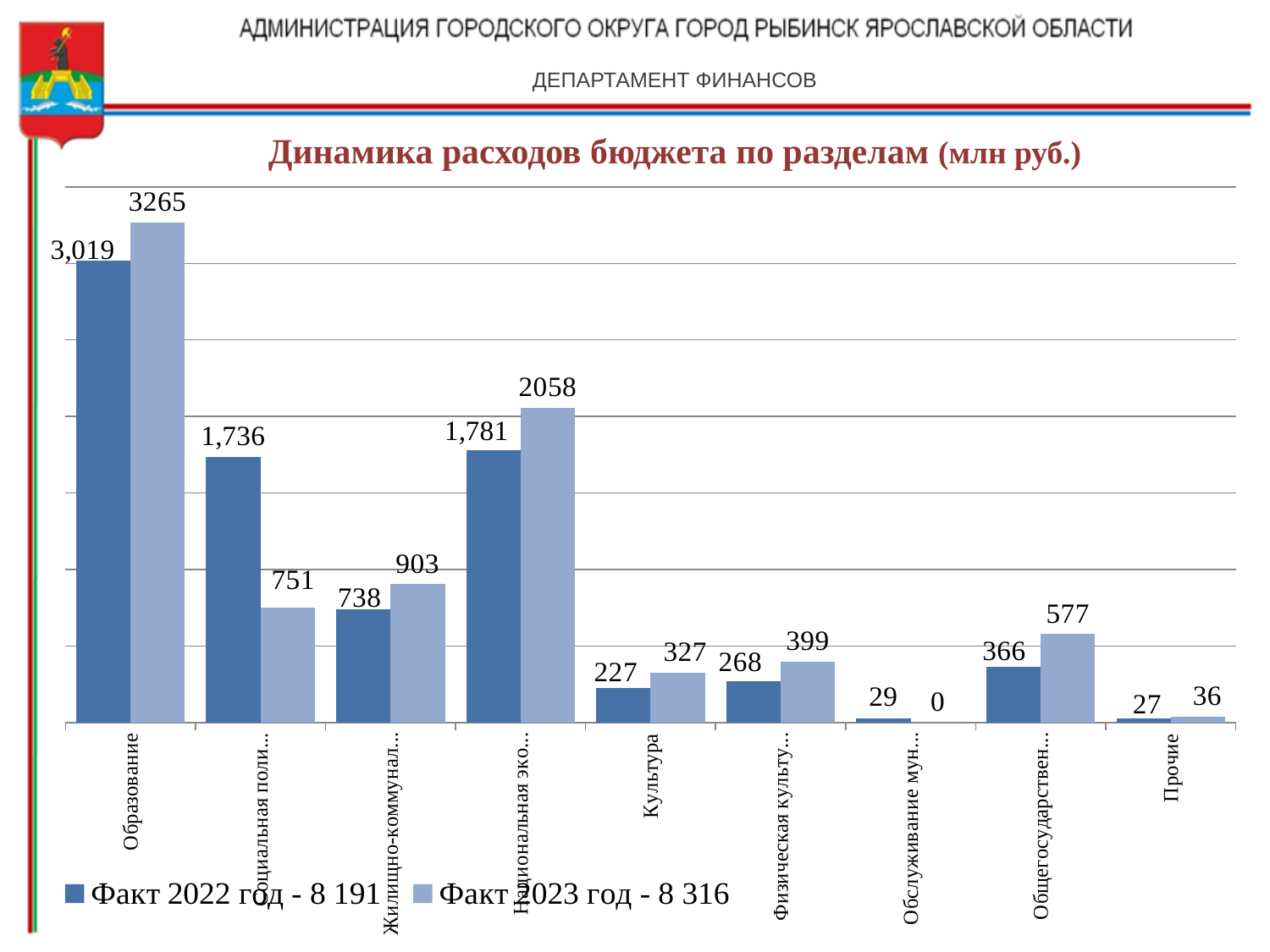
What is the value for Образование in the series Факт 2023 год? 3265 How many categories are shown on the x axis? 9 What is the difference between the Факт 2023 год and Факт 2022 год values for Образование? 246 Which category has the lowest value in the series Факт 2022 год? Прочие What is the value for Прочие in the series Факт 2022 год? 27 Which category has the highest value in the series Факт 2023 год? Образование What type of chart is shown on the slide? bar chart For Прочие, which series has the larger value, Факт 2022 год or Факт 2023 год? Факт 2023 год What is the value for Образование in the series Факт 2022 год? 3,019 How many series does the legend list? 2 What is the difference between the Факт 2023 год and Факт 2022 год values for Культура? 100 What is the value for Культура in the series Факт 2023 год? 327